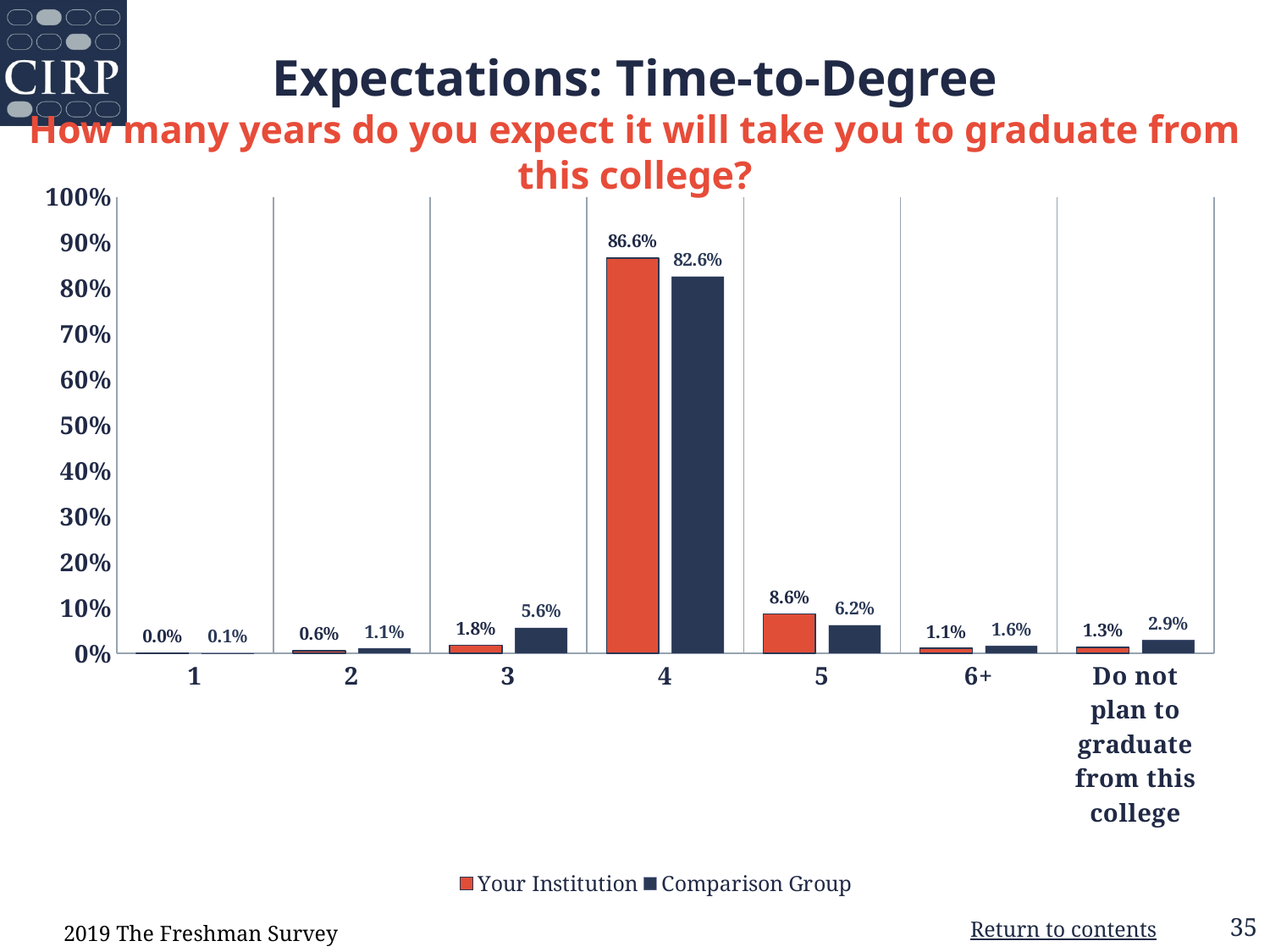
What is the difference between Comparison Group and Your Institution in the 3 category? 3.8% Which is larger in the 5 category, Your Institution or Comparison Group? Your Institution What is the value for Your Institution in the 4 category? 86.6% What kind of chart is shown on the slide? bar chart Which category has the highest value for Your Institution? 4 What is the value for Comparison Group in the 'Do not plan to graduate from this college' category? 2.9% How many categories are shown on the x axis? 7 What is the value for Comparison Group in the 5 category? 6.2% How many series does the legend list? 2 Which category has the lowest value for Your Institution? 1 What is the difference between Your Institution and Comparison Group in the 4 category? 4.0% Is the value for Comparison Group in the 4 category greater or less than 80%? greater